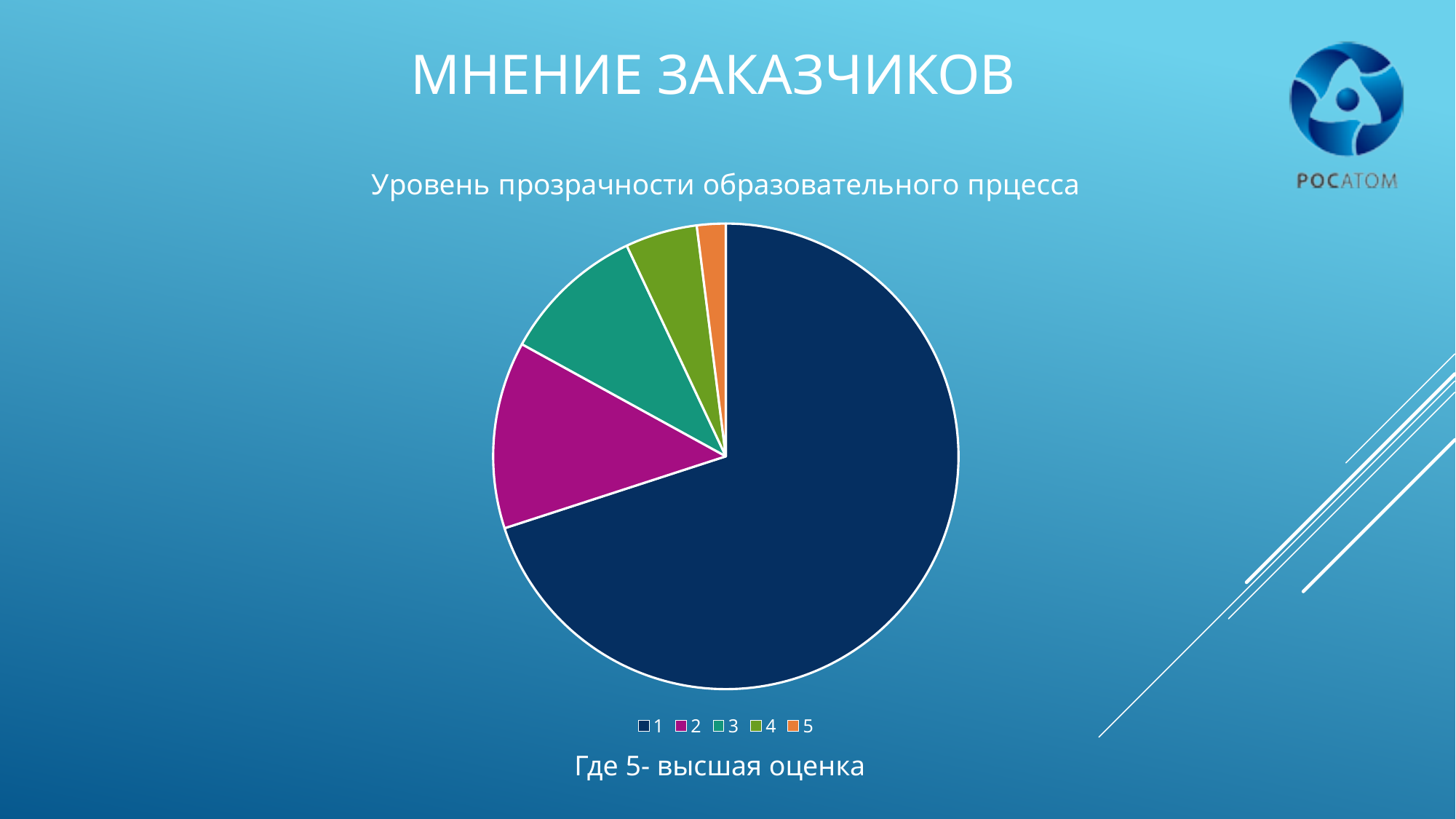
Which slice is larger, category 3 or category 4? 3 How many entries does the chart legend list? 5 Which category has the largest slice of the pie? 1 Which slice is larger, category 1 or category 2? 1 What kind of chart is shown on the slide? Pie chart How many slices does the pie chart have? 5 Which category has the smallest slice of the pie? 5 What colour is the slice for category 2 in the pie chart? Magenta (purple-pink) Which slice is larger, category 2 or category 3? 2 What is the title of the chart? Уровень прозрачности образовательного прцесса